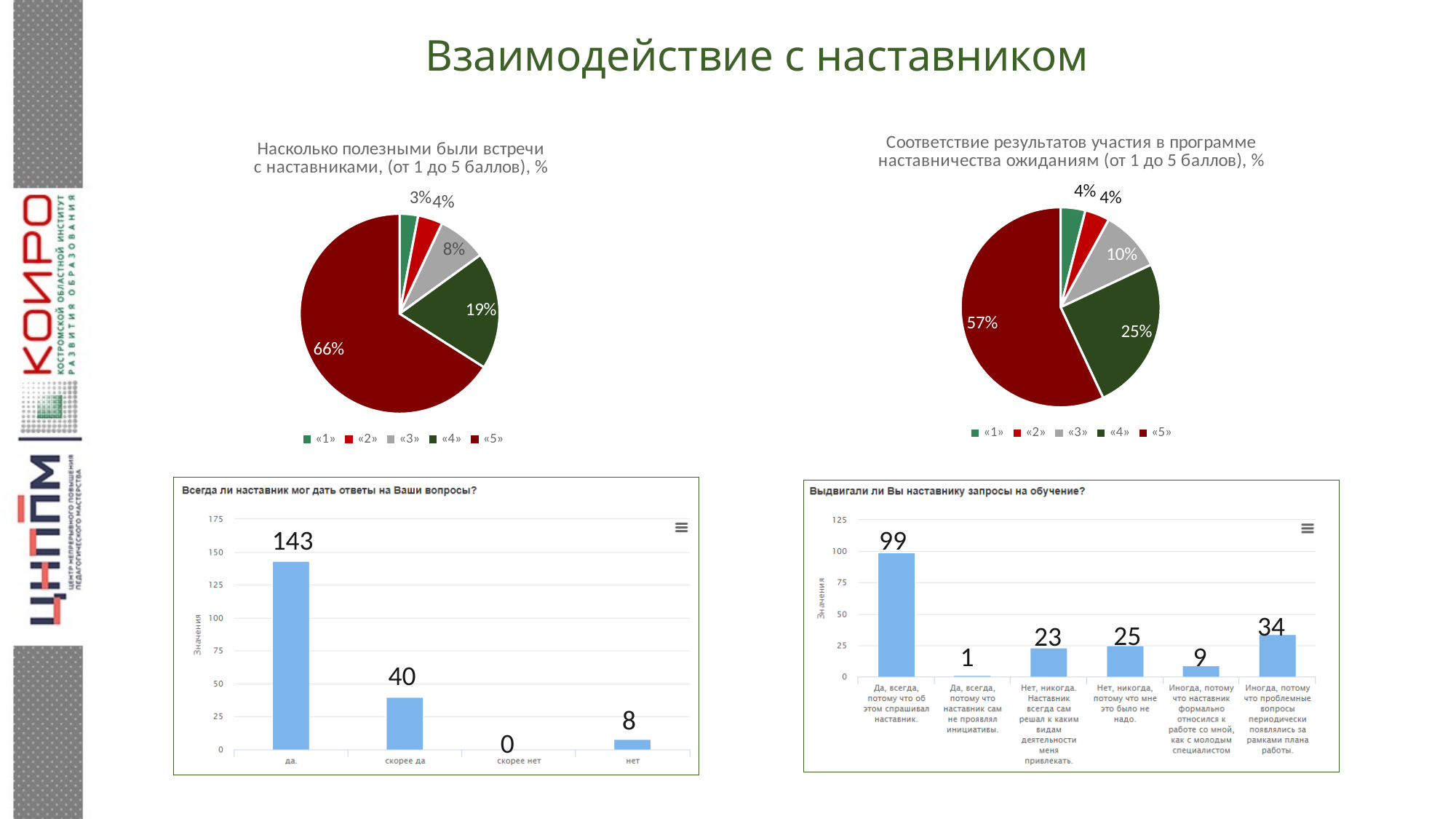
In the bar chart titled "Всегда ли наставник мог дать ответы на Ваши вопросы?", what is the value for "скорее да"? 40 In the pie chart titled "Насколько полезными были встречи с наставниками", what share does the «5» slice have? 66% In the bar chart titled "Всегда ли наставник мог дать ответы на Ваши вопросы?", which category has the highest value? да. How many entries does the legend of the pie chart titled "Соответствие результатов участия в программе наставничества ожиданиям" list? 5 In the bar chart titled "Выдвигали ли Вы наставнику запросы на обучение?", which is larger: "Нет, никогда, потому что мне это было не надо." or "Иногда, потому что проблемные вопросы периодически появлялись за рамками плана работы."? Иногда, потому что проблемные вопросы периодически появлялись за рамками плана работы. How many categories are shown in the bar chart titled "Всегда ли наставник мог дать ответы на Ваши вопросы?"? 4 In the pie chart titled "Насколько полезными были встречи с наставниками", which rating has the smallest slice? «1» What type of chart is the one titled "Выдвигали ли Вы наставнику запросы на обучение?"? bar chart In the pie chart titled "Соответствие результатов участия в программе наставничества ожиданиям", what is the difference between the «5» and «4» slices? 32% In the pie chart titled "Соответствие результатов участия в программе наставничества ожиданиям", what share does the «4» slice have? 25% In the bar chart titled "Выдвигали ли Вы наставнику запросы на обучение?", what is the value for "Да, всегда, потому что об этом спрашивал наставник."? 99 In the bar chart titled "Всегда ли наставник мог дать ответы на Ваши вопросы?", what is the difference between "да." and "нет"? 135